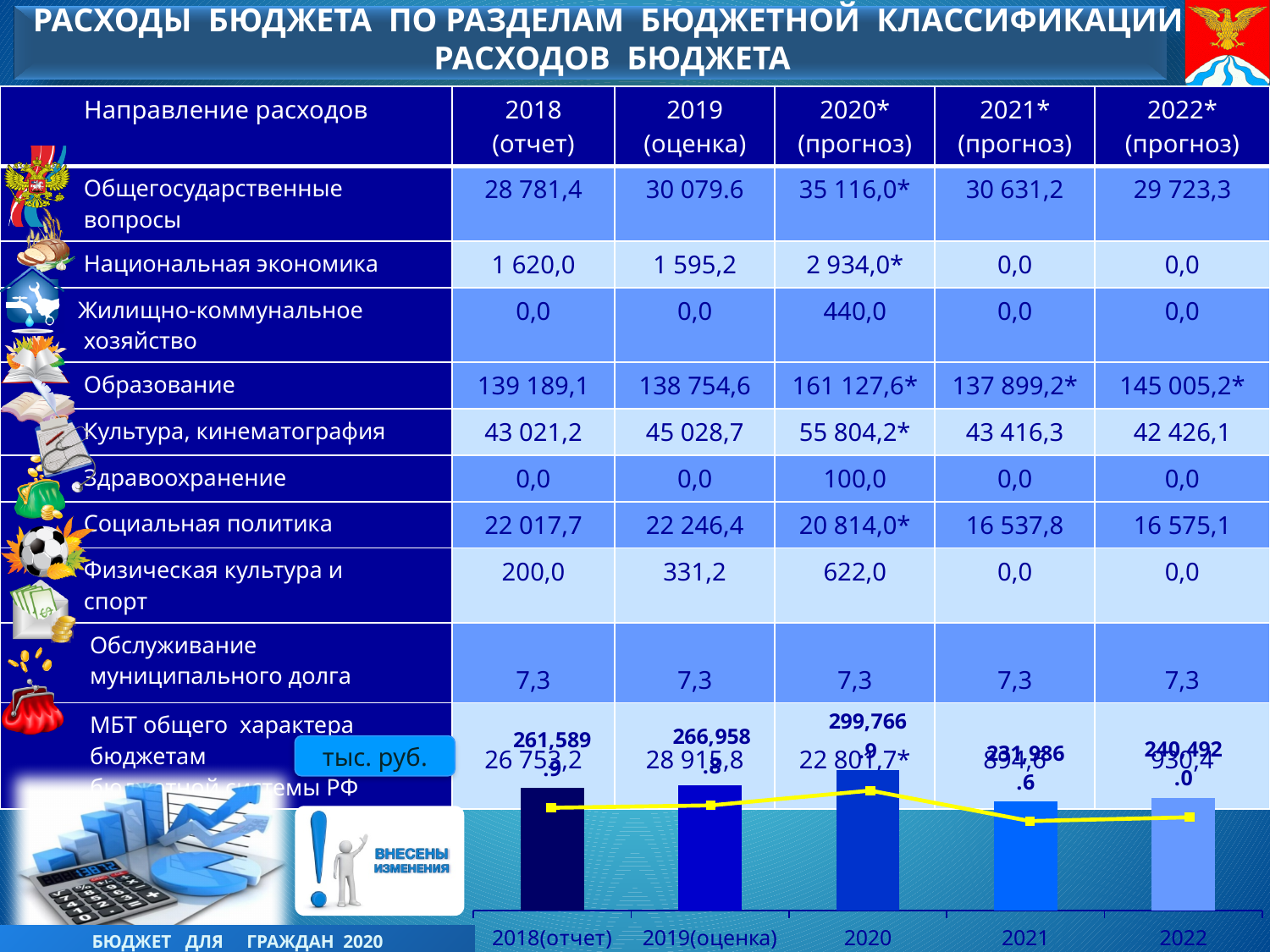
In the chart at the bottom of the slide, which is larger, the value for 2021 or for 2022? 2022 In the chart at the bottom of the slide, what is the difference between the values for 2019(оценка) and 2018(отчет)? 5,368.9 In the chart at the bottom of the slide, what is the value for 2022? 240,492.0 In the chart at the bottom of the slide, which is larger, the value for 2018(отчет) or for 2019(оценка)? 2019(оценка) In the chart at the bottom of the slide, which year has the lowest value? 2021 In the chart at the bottom of the slide, what is the value for 2021? 231,986.6 In the chart at the bottom of the slide, what is the value for 2018(отчет)? 261,589.9 What unit is indicated for the values in the chart at the bottom of the slide? тыс. руб. How many bars (years) are plotted in the chart at the bottom of the slide? 5 In the chart at the bottom of the slide, what is the value for 2019(оценка)? 266,958.8 What kind of chart is shown at the bottom of the slide? bar chart with a line overlay In the chart at the bottom of the slide, which year has the highest value? 2020